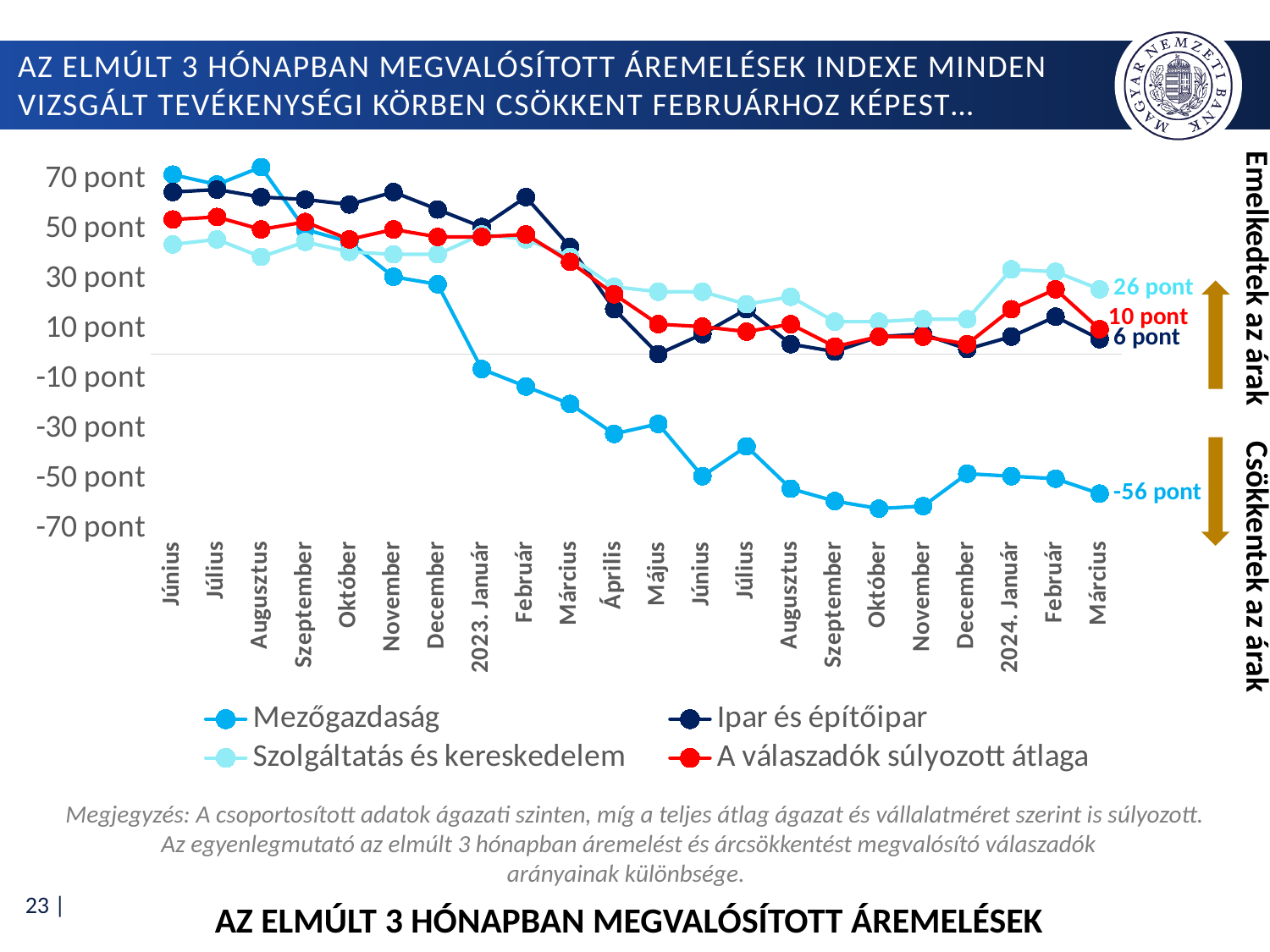
What is the value for Szolgáltatás és kereskedelem in Március 2024? 26 pont Which series has the lowest value in Március 2024? Mezőgazdaság What is the value for Mezőgazdaság in Március 2024? -56 pont What kind of chart is shown on the slide? line chart Is the value for Mezőgazdaság in Május 2023 greater or less than -10 pont? less What is the value for Ipar és építőipar in Március 2024? 6 pont How many series does the legend list? 4 Does the Mezőgazdaság series rise or fall overall from Június 2022 to Március 2024? fall What is the value for A válaszadók súlyozott átlaga in Március 2024? 10 pont Which is larger in Március 2024: Mezőgazdaság or Ipar és építőipar? Ipar és építőipar Which series has the highest value in Március 2024? Szolgáltatás és kereskedelem What is the difference between Szolgáltatás és kereskedelem and Ipar és építőipar in Március 2024? 20 pont